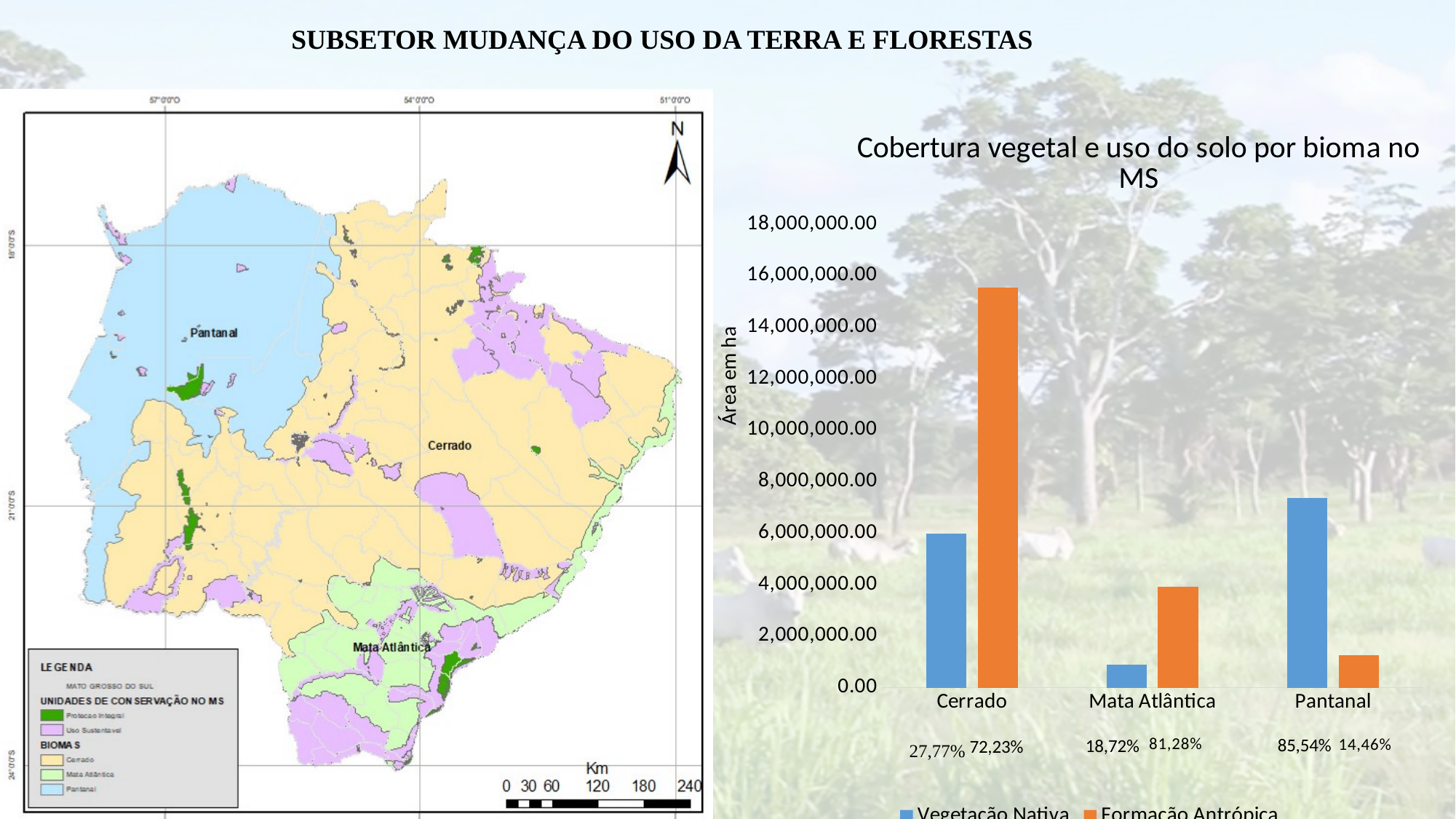
What is the y-axis title of the bar chart? Área em ha In the bar chart, for Cerrado, which is larger: Vegetação Nativa or Formação Antrópica? Formação Antrópica In the bar chart, which biome has the lowest Vegetação Nativa value? Mata Atlântica In the bar chart, which biome has the highest Formação Antrópica value? Cerrado In the bar chart, for Pantanal, which is larger: Vegetação Nativa or Formação Antrópica? Vegetação Nativa In the bar chart, is the Vegetação Nativa value for Pantanal greater or less than 8,000,000.00? less What type of chart is 'Cobertura vegetal e uso do solo por bioma no MS'? bar chart In the bar chart, which biome has the highest Vegetação Nativa value? Pantanal How many series does the legend of the bar chart list? 2 How many biomes (categories) are shown on the x axis of the bar chart? 3 In the bar chart, is the Formação Antrópica value for Cerrado greater or less than 14,000,000.00? greater In the bar chart, is the Vegetação Nativa value for Mata Atlântica greater or less than 2,000,000.00? less